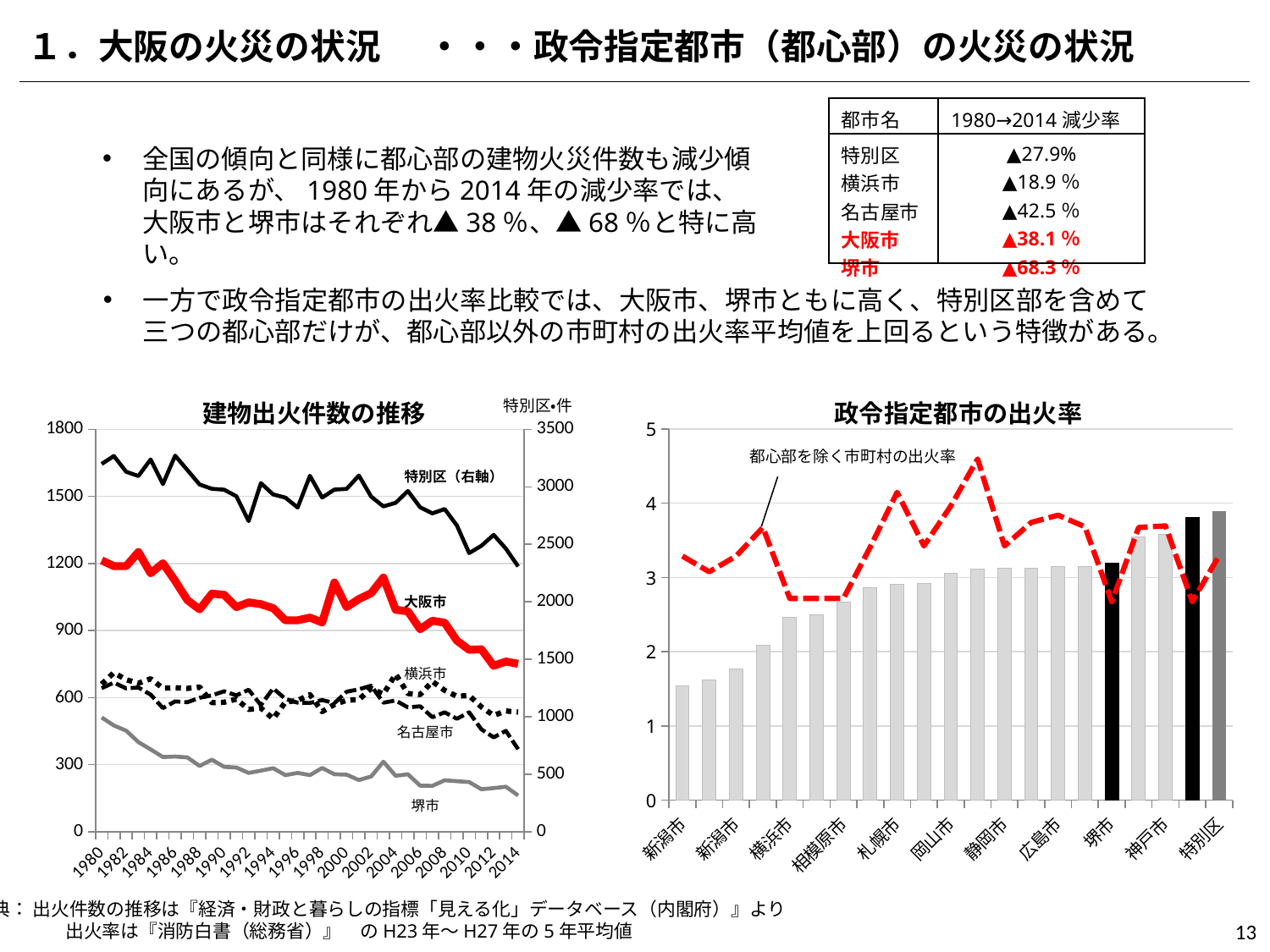
In the left chart 建物出火件数の推移, which series is plotted against the right axis? 特別区 What kind of chart is the left chart titled 建物出火件数の推移? line chart In the left chart 建物出火件数の推移, how many city lines are plotted? 5 What kind of chart is the right chart titled 政令指定都市の出火率? bar chart In the left chart 建物出火件数の推移, is the value for 大阪市 in 1980 greater or less than 900? greater In the right chart 政令指定都市の出火率, which bar is higher, 特別区 or 横浜市? 特別区 In the right chart 政令指定都市の出火率, is the bar for 特別区 greater or less than 3? greater In the left chart 建物出火件数の推移, which is higher in 1980, 大阪市 or 横浜市? 大阪市 In the left chart 建物出火件数の推移, does the 堺市 line rise or fall from 1980 to 2014? fall In the left chart 建物出火件数の推移, does the 特別区 line rise or fall from 1980 to 2014? fall In the right chart 政令指定都市の出火率, what does the red dashed line represent? 都心部を除く市町村の出火率 In the left chart 建物出火件数の推移, is the value for 堺市 in 2014 greater or less than 300? less